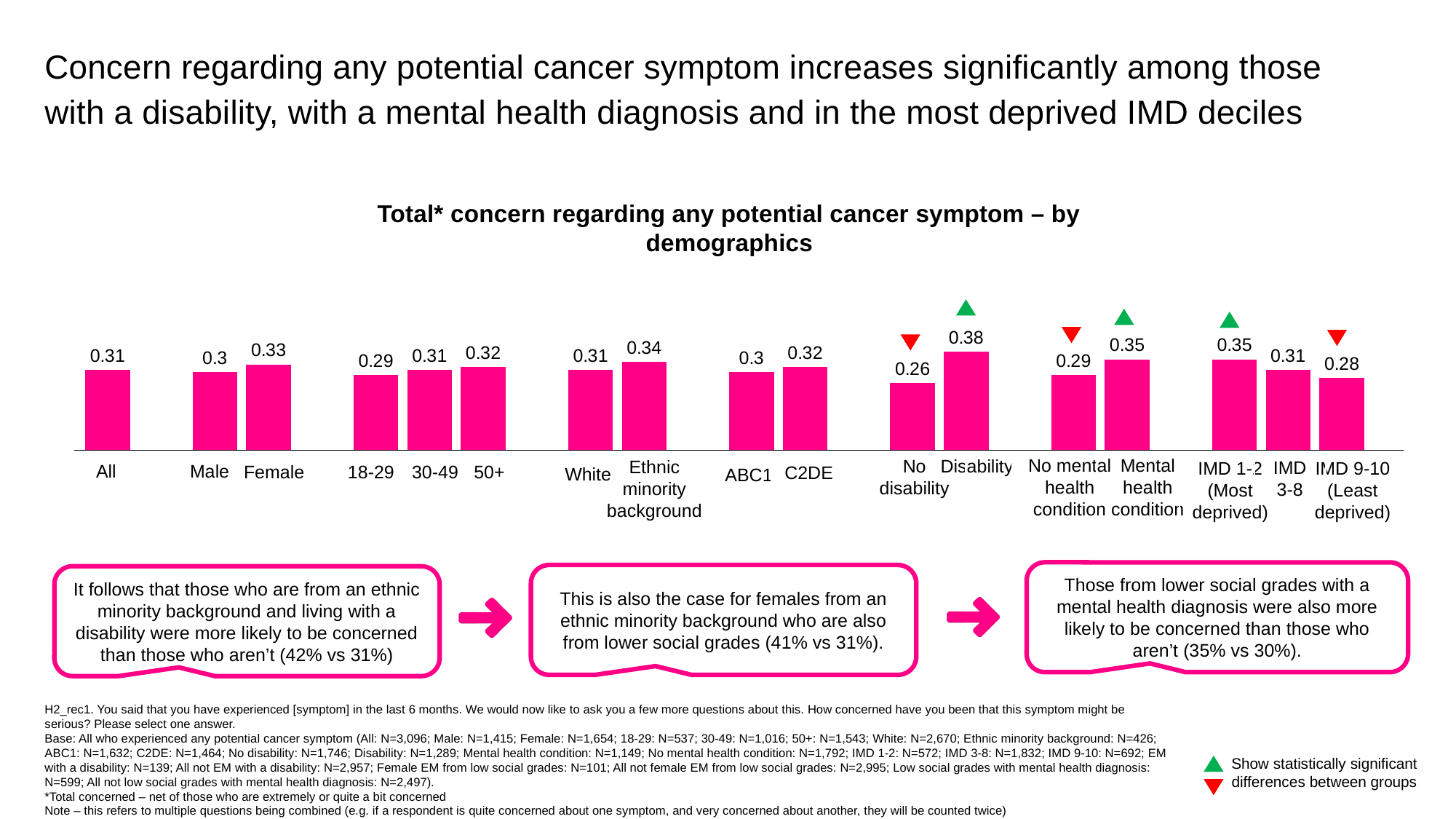
Which category has the lowest value? No disability What is the value for Disability? 0.38 What is the difference between the values for Disability and No disability? 0.12 What kind of chart is shown? Bar chart What is the value for IMD 9-10 (Least deprived)? 0.28 Which category has the highest value? Disability What is the difference between the values for Mental health condition and No mental health condition? 0.06 What is the title of the chart? Total* concern regarding any potential cancer symptom – by demographics What is the value for Ethnic minority background? 0.34 What is the value for No disability? 0.26 How many bars are shown in the chart? 17 Which is larger, the value for Female or the value for Male? Female